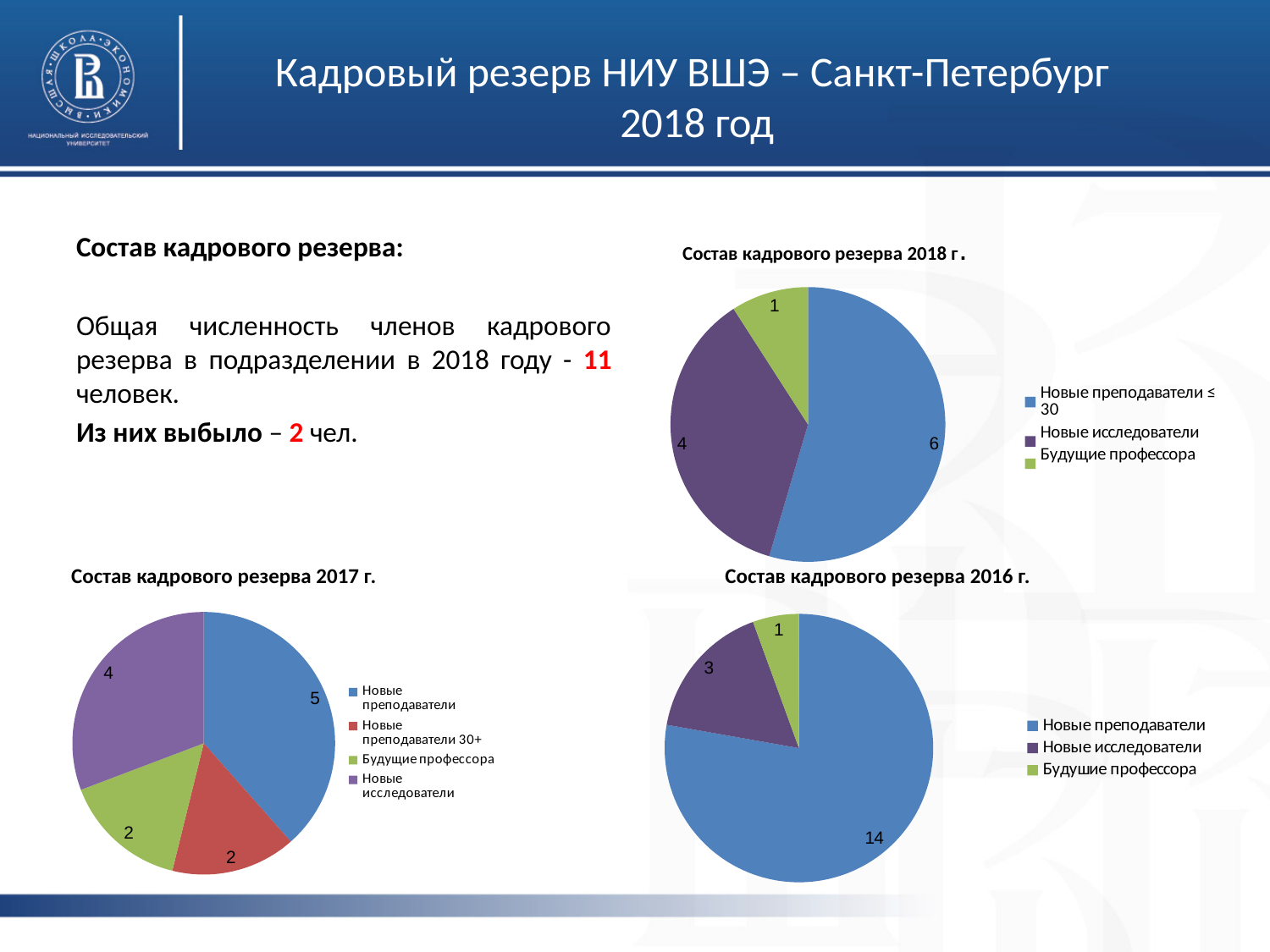
In the chart 'Состав кадрового резерва 2017 г.', what colour is the slice for Будущие профессора? Green In the chart 'Состав кадрового резерва 2018 г.', what is the difference between Новые преподаватели ≤ 30 and Новые исследователи? 2 In the chart 'Состав кадрового резерва 2016 г.', which is larger: Новые исследователи or Будущие профессора? Новые исследователи In the chart 'Состав кадрового резерва 2017 г.', how many categories are shown? 4 In the chart 'Состав кадрового резерва 2018 г.', which category has the smallest slice? Будущие профессора In the chart 'Состав кадрового резерва 2016 г.', what is the value for Новые преподаватели? 14 What type of chart is 'Состав кадрового резерва 2016 г.'? Pie chart In the chart 'Состав кадрового резерва 2017 г.', which category has the largest slice? Новые преподаватели In the chart 'Состав кадрового резерва 2018 г.', how many categories does the legend list? 3 In the chart 'Состав кадрового резерва 2017 г.', what is the value for Новые исследователи? 4 In the chart 'Состав кадрового резерва 2016 г.', what is the total of all slices? 18 In the chart 'Состав кадрового резерва 2018 г.', what is the value for Новые преподаватели ≤ 30? 6